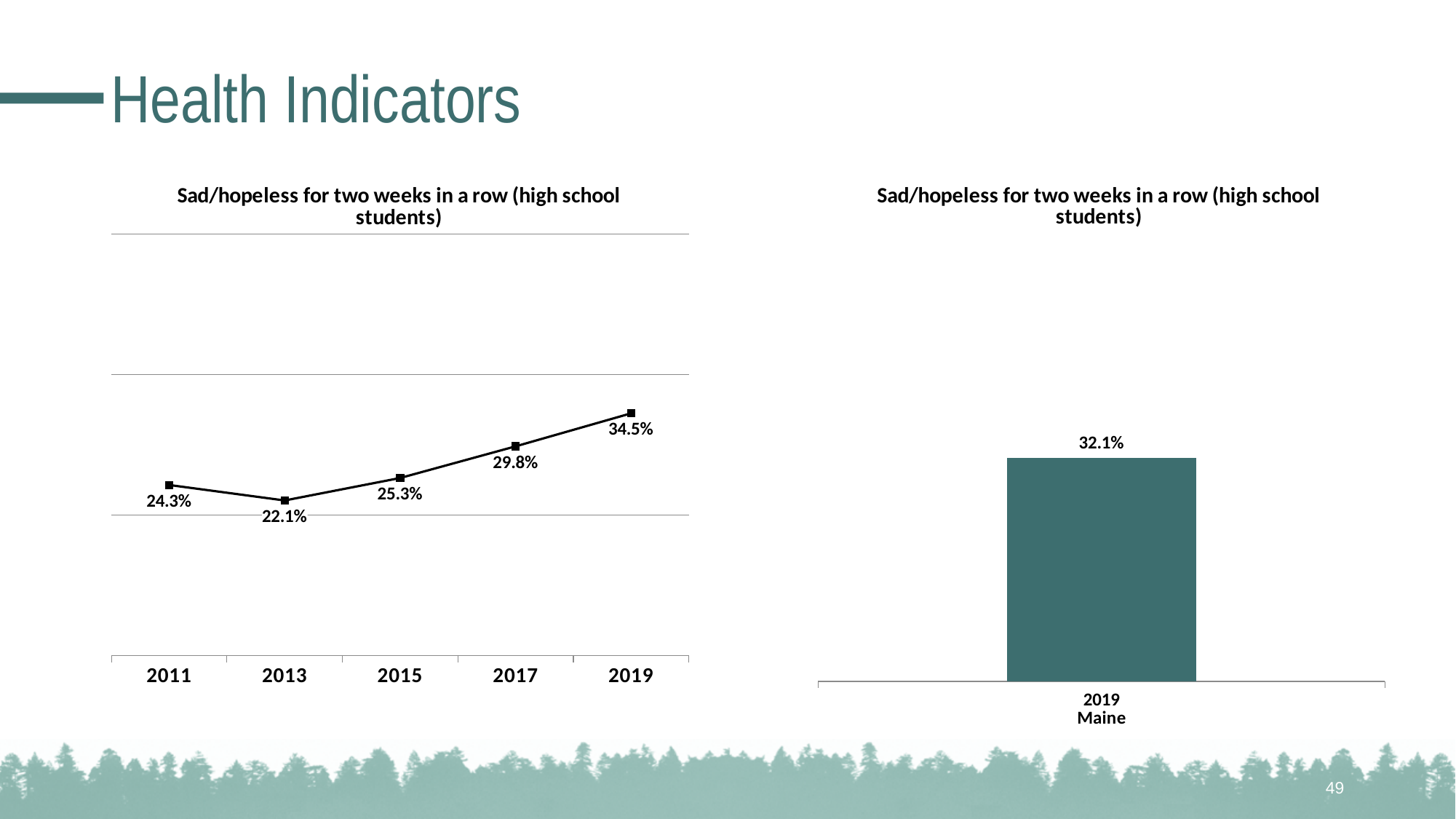
What kind of chart is the right chart? bar chart How many data points are plotted in the left chart? 5 In the left chart, what is the difference between the 2019 and 2017 values? 4.7% In the left chart, which year has the lowest value? 2013 What kind of chart is the left chart? line chart In the left chart, do the values rise or fall from 2013 to 2019? rise In the left chart, what is the value for 2013? 22.1% In the left chart, which year has the highest value? 2019 In the left chart, what is the value for 2019? 34.5% In the right chart, what is the value for Maine in 2019? 32.1% In the left chart, what is the value for 2011? 24.3% In the left chart, which is larger, the value for 2011 or the value for 2015? 2015